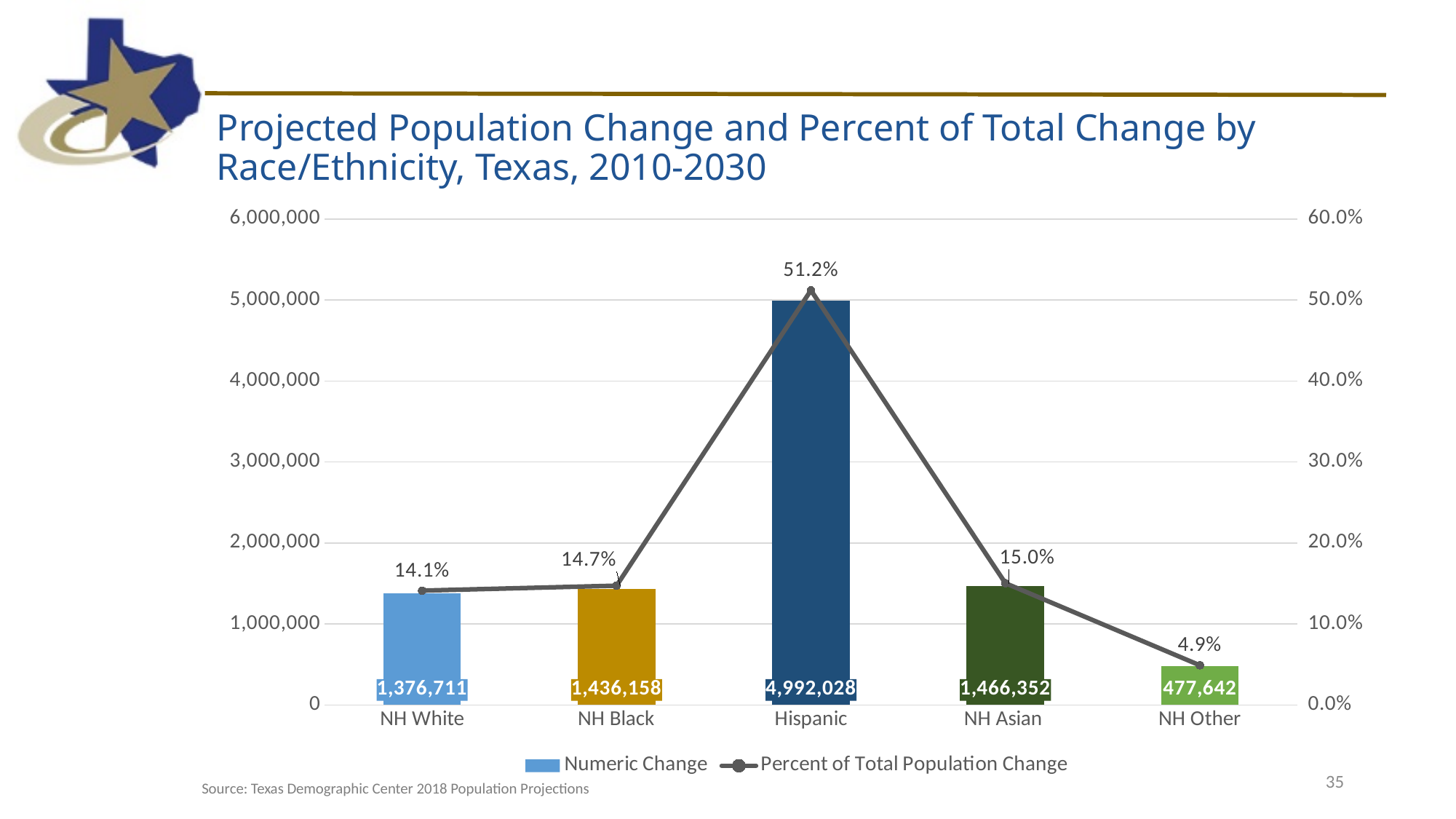
What is the difference in Numeric Change between NH Asian and NH Black? 30,194 Which race/ethnicity group has the lowest Percent of Total Population Change? NH Other What is the Percent of Total Population Change for NH Asian? 15.0% What kind of chart is shown on the slide? Combination bar and line chart Which race/ethnicity group has the highest Numeric Change? Hispanic What is the difference in Percent of Total Population Change between Hispanic and NH Other? 46.3% How many race/ethnicity categories are shown on the x axis? 5 What is the Numeric Change for Hispanic? 4,992,028 What is the Percent of Total Population Change for NH White? 14.1% What is the Numeric Change for NH Other? 477,642 How many series does the legend list? 2 Which has a larger Numeric Change, NH White or NH Black? NH Black